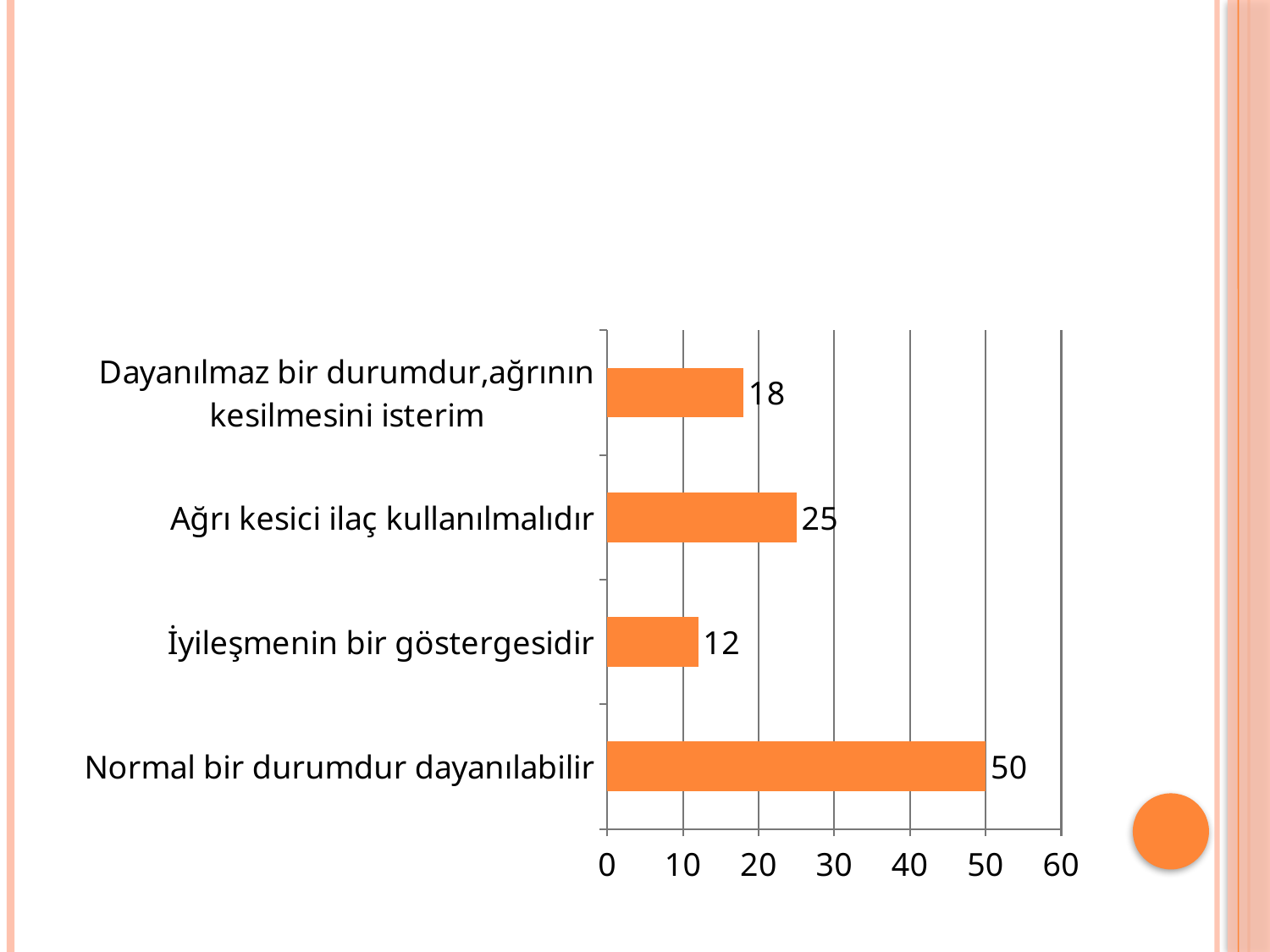
Which category has the lowest value? İyileşmenin bir göstergesidir What is the difference between the values for "Normal bir durumdur dayanılabilir" and "Ağrı kesici ilaç kullanılmalıdır"? 25 What is the value for "Dayanılmaz bir durumdur,ağrının kesilmesini isterim"? 18 What is the value for "Normal bir durumdur dayanılabilir"? 50 What is the difference between the values for "Dayanılmaz bir durumdur,ağrının kesilmesini isterim" and "İyileşmenin bir göstergesidir"? 6 How many categories are shown in the chart? 4 Which category has the highest value? Normal bir durumdur dayanılabilir What is the value for "İyileşmenin bir göstergesidir"? 12 Is the value for "Normal bir durumdur dayanılabilir" greater or less than 40? greater What kind of chart is shown on the slide? bar chart What is the value for "Ağrı kesici ilaç kullanılmalıdır"? 25 Which is larger: the value for "Ağrı kesici ilaç kullanılmalıdır" or the value for "Dayanılmaz bir durumdur,ağrının kesilmesini isterim"? Ağrı kesici ilaç kullanılmalıdır